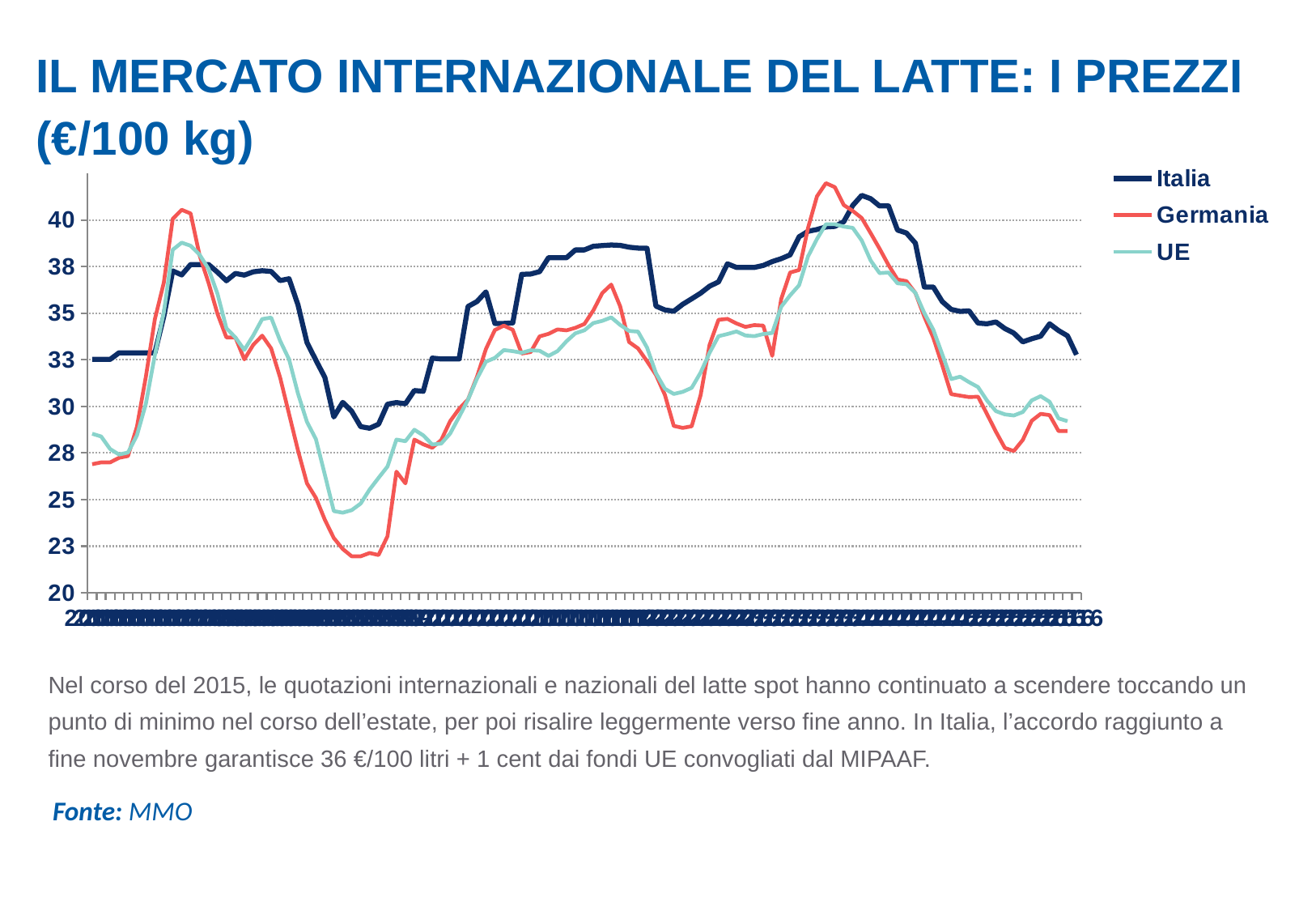
Which series reaches the lowest value anywhere on the chart? Germania Is the highest point of the Germania line greater or less than 40? greater At the right-hand end of the chart, which line is higher: Italia or Germania? Italia How many series does the chart legend list? 3 Is the highest point of the Italia line greater or less than 40? greater Is the lowest point of the UE line greater or less than 25? less What kind of chart is shown on the slide? Line chart Over the final stretch of the chart after the last peak, do the Italia values rise or fall? Fall What colour is the Germania line in the chart? Red Which series are listed in the chart legend? Italia, Germania, UE